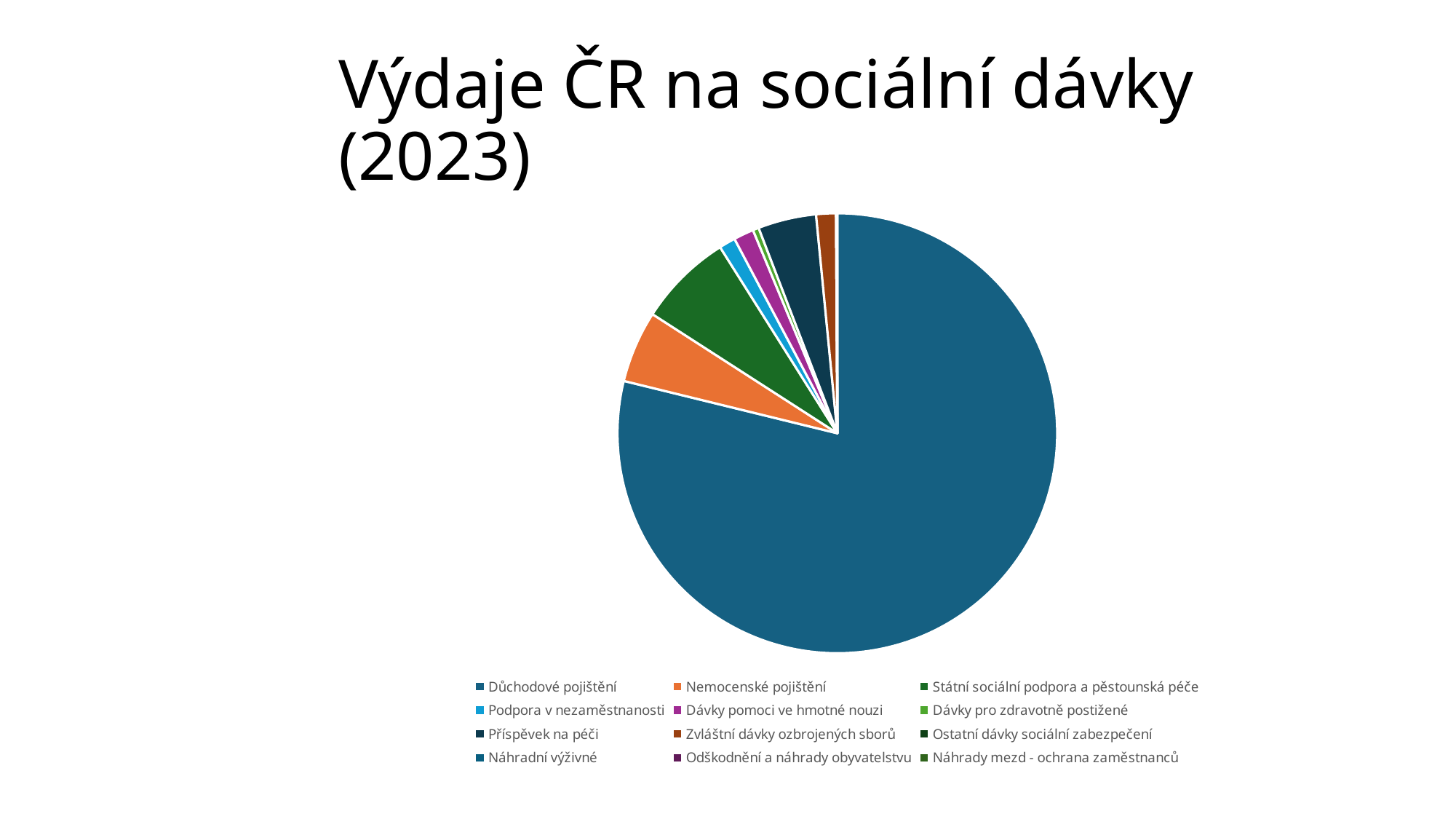
What is the title of the chart on the slide? Výdaje ČR na sociální dávky (2023) Which slice is larger, Příspěvek na péči or Zvláštní dávky ozbrojených sborů? Příspěvek na péči Which slice is larger, Nemocenské pojištění or Dávky pomoci ve hmotné nouzi? Nemocenské pojištění What colour is the slice for Nemocenské pojištění? orange Does the slice for Důchodové pojištění take up more or less than half of the pie? more How many categories does the legend list? 12 What kind of chart is shown on the slide? pie chart Which category has the largest slice of the pie? Důchodové pojištění Which slice is larger, Státní sociální podpora a pěstounská péče or Podpora v nezaměstnanosti? Státní sociální podpora a pěstounská péče